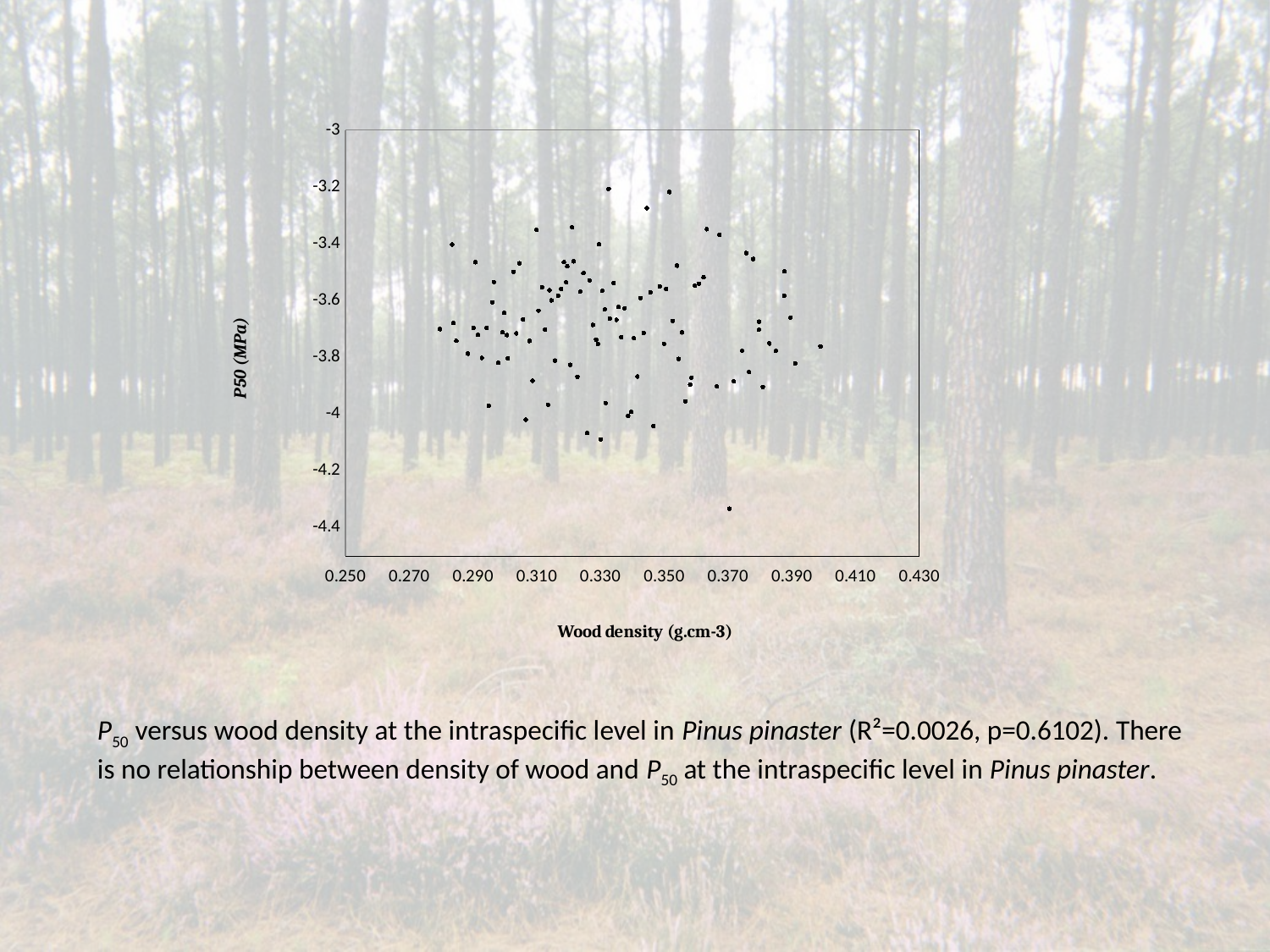
Is the smallest wood density value plotted greater or less than 0.270? greater Is the P50 value of the lowest point on the chart greater or less than -4? less What is the label of the x axis of the chart? Wood density (g.cm-3) Is the largest wood density value plotted greater or less than 0.410? less Do the P50 values show a clear rise or fall as wood density increases along the x axis? no clear trend What kind of chart is shown on the slide? scatter plot What is the label of the y axis of the chart? P50 (MPa)